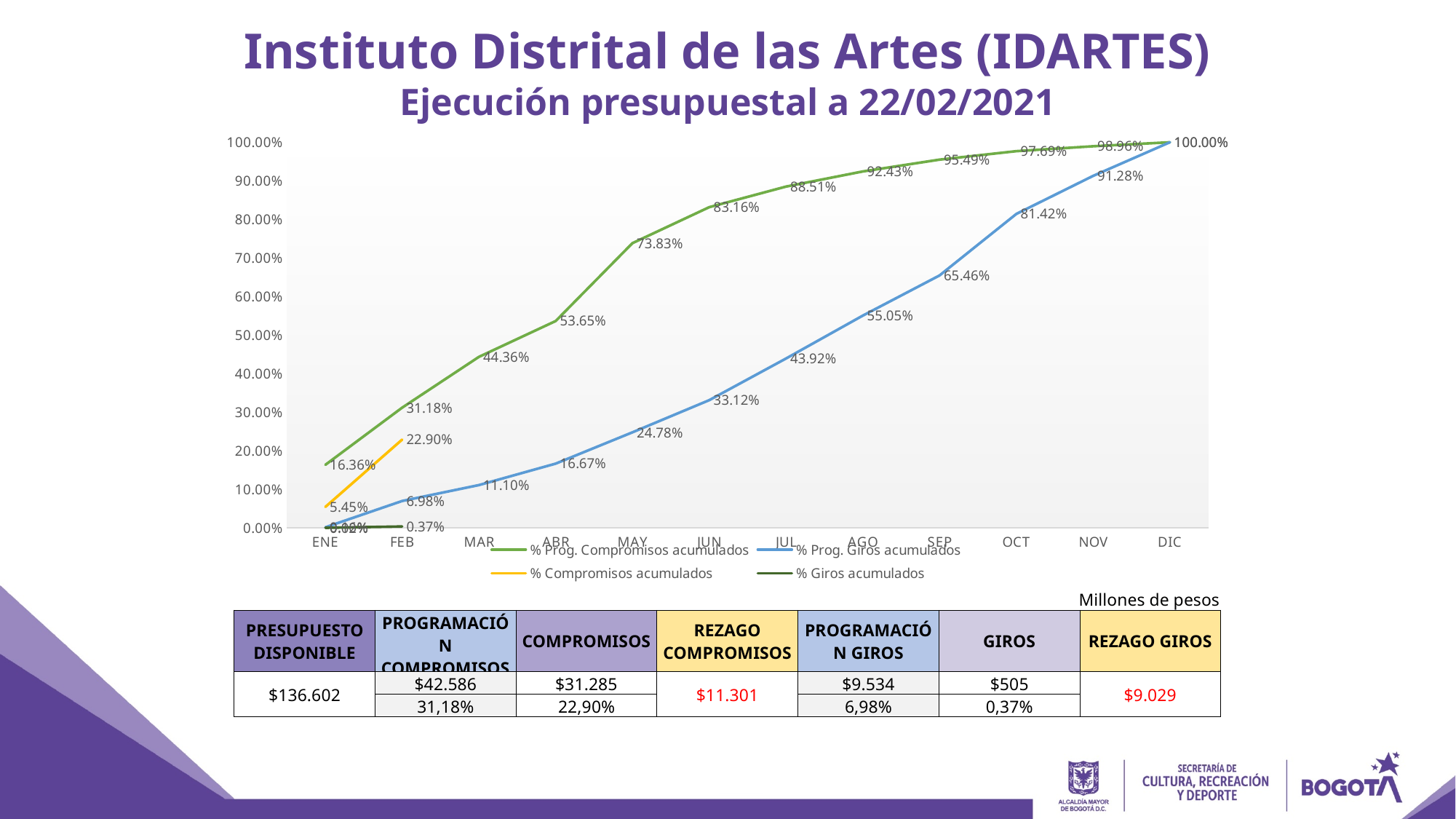
What is the difference between % Prog. Compromisos acumulados and % Prog. Giros acumulados in FEB? 24.20% What is the value of % Prog. Compromisos acumulados in MAY? 73.83% What is the value of % Compromisos acumulados in FEB? 22.90% Which is larger in JUL: % Prog. Compromisos acumulados or % Prog. Giros acumulados? % Prog. Compromisos acumulados Does % Prog. Giros acumulados rise or fall from ENE to DIC? rise What is the value of % Prog. Giros acumulados in OCT? 81.42% How many series does the chart legend list? 4 In which month does % Prog. Giros acumulados reach its highest value? DIC How many months are shown on the x axis of the chart? 12 What type of chart is shown on the slide? line chart What is the value of % Giros acumulados in FEB? 0.37% In which month is % Prog. Compromisos acumulados lowest? ENE